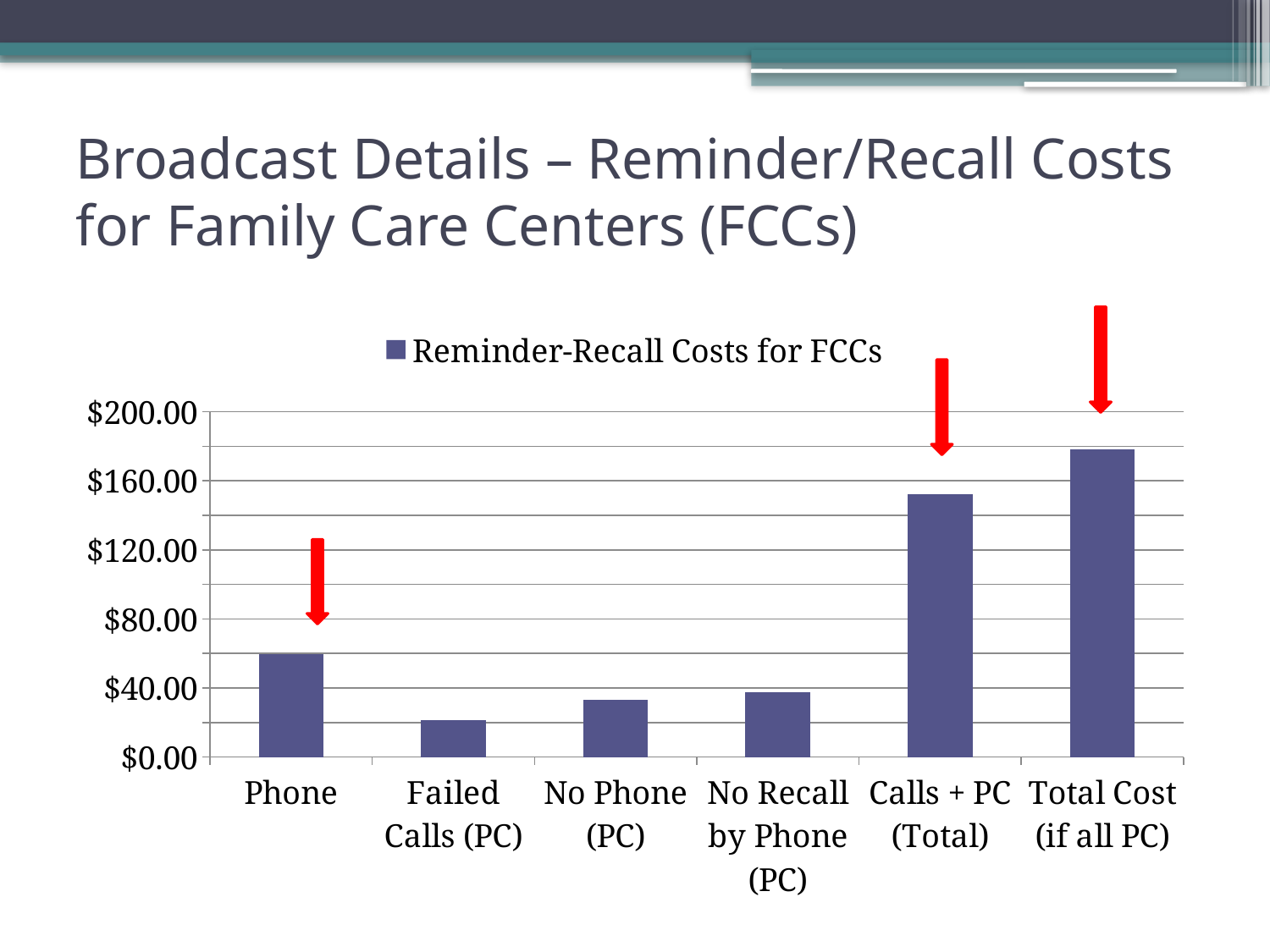
How many series does the chart's legend list? 1 Which is larger, the cost for Calls + PC (Total) or the cost for Total Cost (if all PC)? Total Cost (if all PC) Which category has the lowest cost in the chart? Failed Calls (PC) Is the value for Failed Calls (PC) greater or less than $40.00? less Is the value for Total Cost (if all PC) greater or less than $200.00? less Which category has the highest cost in the chart? Total Cost (if all PC) Is the value for Calls + PC (Total) greater or less than $120.00? greater How many categories are shown on the x axis of the chart? 6 What kind of chart is shown on the slide? bar chart Which is larger, the cost for Phone or the cost for Failed Calls (PC)? Phone What is the legend entry shown above the chart? Reminder-Recall Costs for FCCs